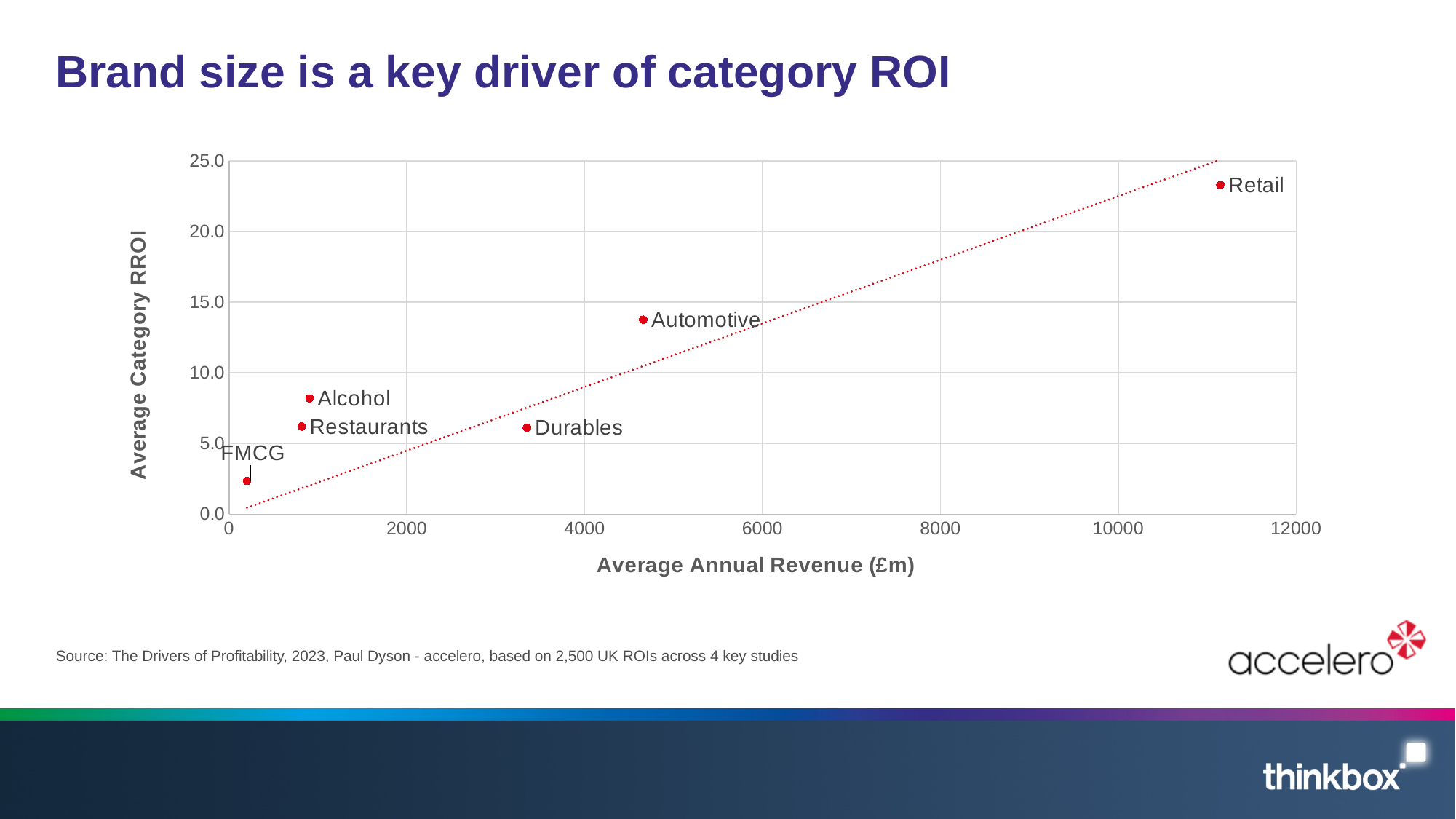
Which category has the lowest Average Category RROI? FMCG Which has the higher Average Category RROI, Alcohol or Restaurants? Alcohol What kind of chart is shown on the slide? Scatter chart Is the Average Category RROI for Retail greater or less than 20.0? greater Which has the higher Average Category RROI, Automotive or Durables? Automotive How many categories are plotted on the chart? 6 Which category has the highest Average Annual Revenue? Retail Is the Average Annual Revenue for Durables greater or less than 4000? less Which category has the highest Average Category RROI? Retail What is the label of the x axis? Average Annual Revenue (£m) Does Average Category RROI generally rise or fall as Average Annual Revenue increases? Rise Is the Average Category RROI for Automotive greater or less than 15.0? less